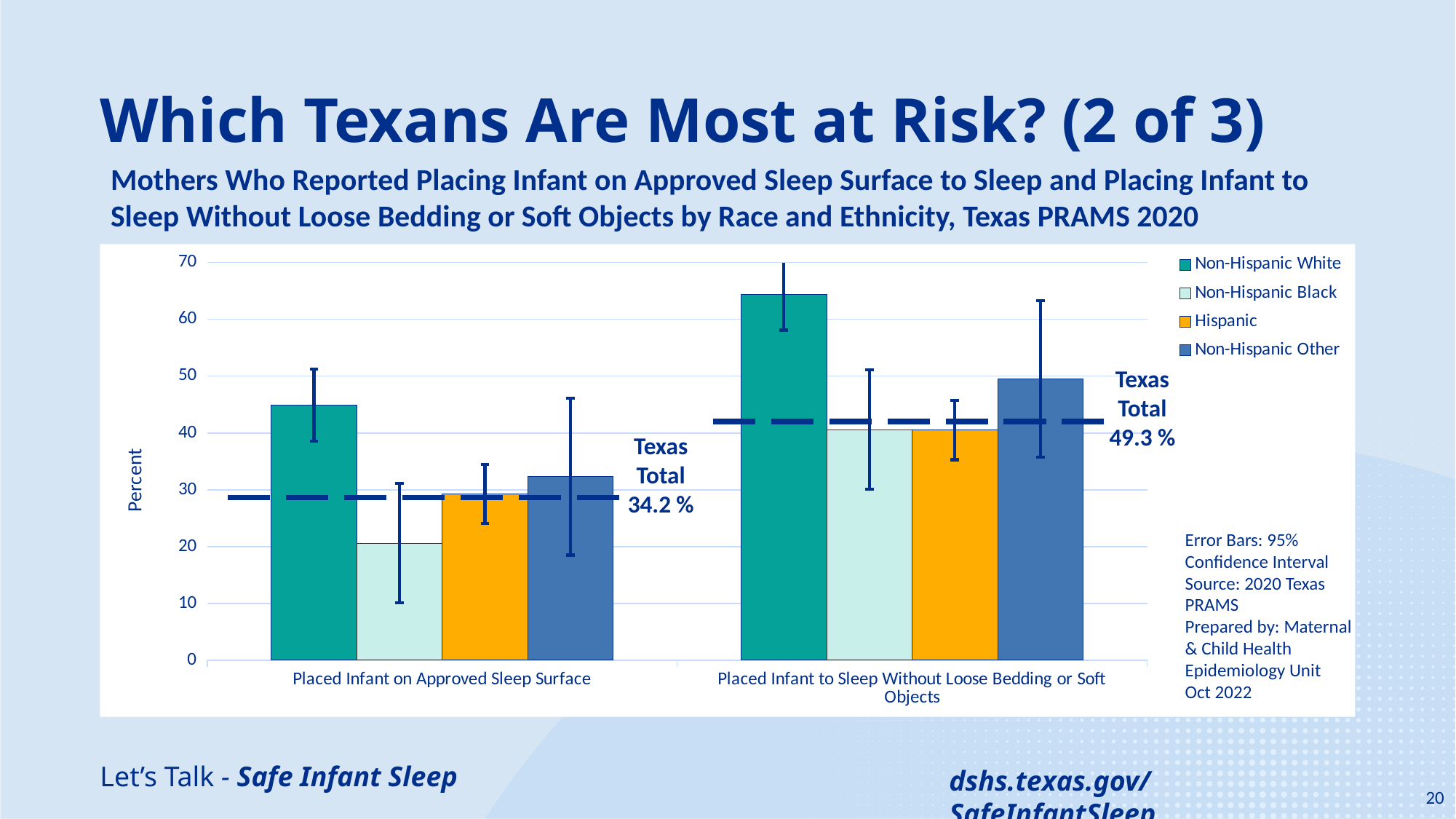
According to the note on the slide, what do the error bars represent? 95% Confidence Interval Which race/ethnicity group has the lowest value for Placed Infant on Approved Sleep Surface? Non-Hispanic Black Which race/ethnicity group has the highest value for Placed Infant to Sleep Without Loose Bedding or Soft Objects? Non-Hispanic White What kind of chart is shown on the slide? bar chart For Placed Infant to Sleep Without Loose Bedding or Soft Objects, which is larger: Non-Hispanic White or Non-Hispanic Other? Non-Hispanic White How many series does the legend list? 4 How many categories are shown on the x axis? 2 Is the value for Non-Hispanic White for Placed Infant on Approved Sleep Surface greater or less than 40? greater What is the Texas Total shown for Placed Infant to Sleep Without Loose Bedding or Soft Objects? 49.3 % What is the Texas Total shown for Placed Infant on Approved Sleep Surface? 34.2 % Which race/ethnicity group has the highest value for Placed Infant on Approved Sleep Surface? Non-Hispanic White Is the value for Non-Hispanic White for Placed Infant to Sleep Without Loose Bedding or Soft Objects greater or less than 60? greater